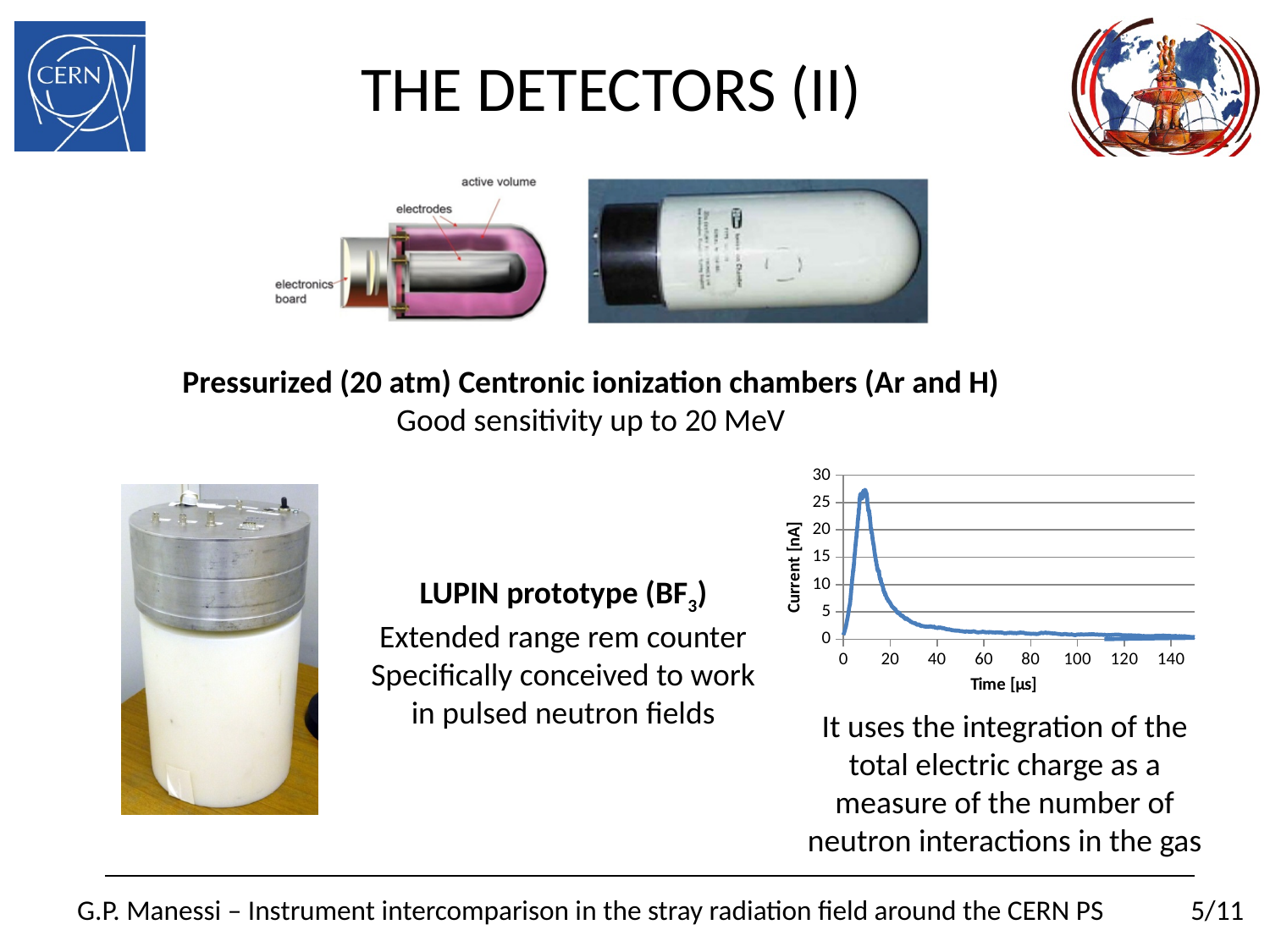
Does the peak of the current occur at a time less than or greater than 20 µs? less Is the current at a time of 140 µs greater or less than 5 nA? less What kind of chart is shown on the slide? line chart Is the current at a time of 60 µs greater or less than 5 nA? less Which is larger, the current at 20 µs or the current at 100 µs? the current at 20 µs After reaching its peak, does the current rise or fall as time increases? fall What is the highest tick value shown on the y axis of the chart? 30 What is the label of the y axis of the chart? Current [nA] What is the label of the x axis of the chart? Time [µs]